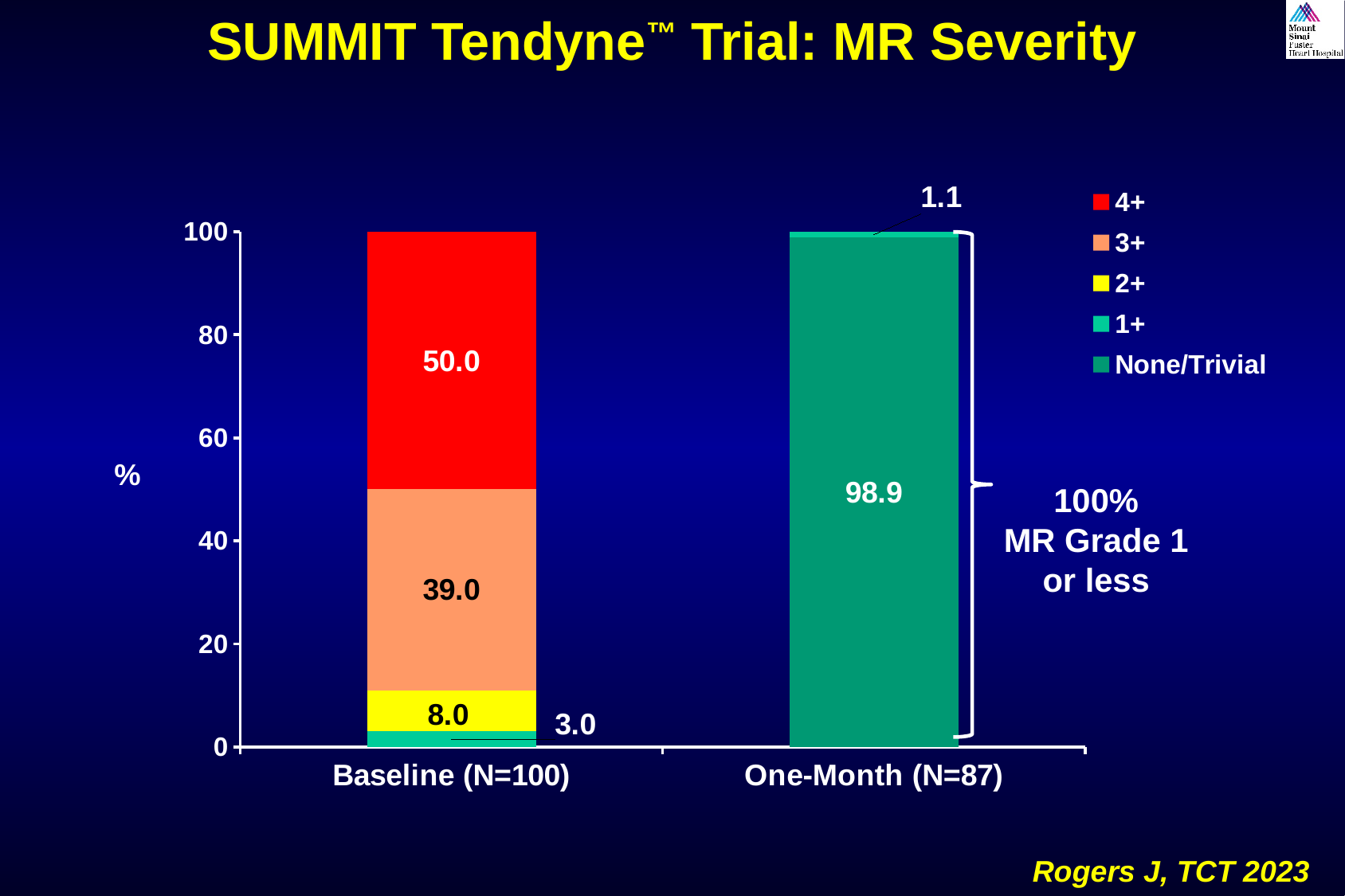
How many categories are shown on the x axis? 2 What is the difference between the 4+ and 3+ values in the Baseline (N=100) bar? 11.0 Which MR severity grade has the largest share of the Baseline (N=100) bar? 4+ Which is larger: the None/Trivial value at One-Month (N=87) or the 4+ value at Baseline (N=100)? None/Trivial at One-Month (N=87) What is the value for 3+ in the Baseline (N=100) bar? 39.0 How many series does the legend list? 5 What is the value for None/Trivial in the One-Month (N=87) bar? 98.9 What is the value for 4+ in the Baseline (N=100) bar? 50.0 What is the value for 1+ in the One-Month (N=87) bar? 1.1 What is the value for 2+ in the Baseline (N=100) bar? 8.0 What kind of chart is shown on the slide? Stacked bar chart What is the value for 1+ in the Baseline (N=100) bar? 3.0